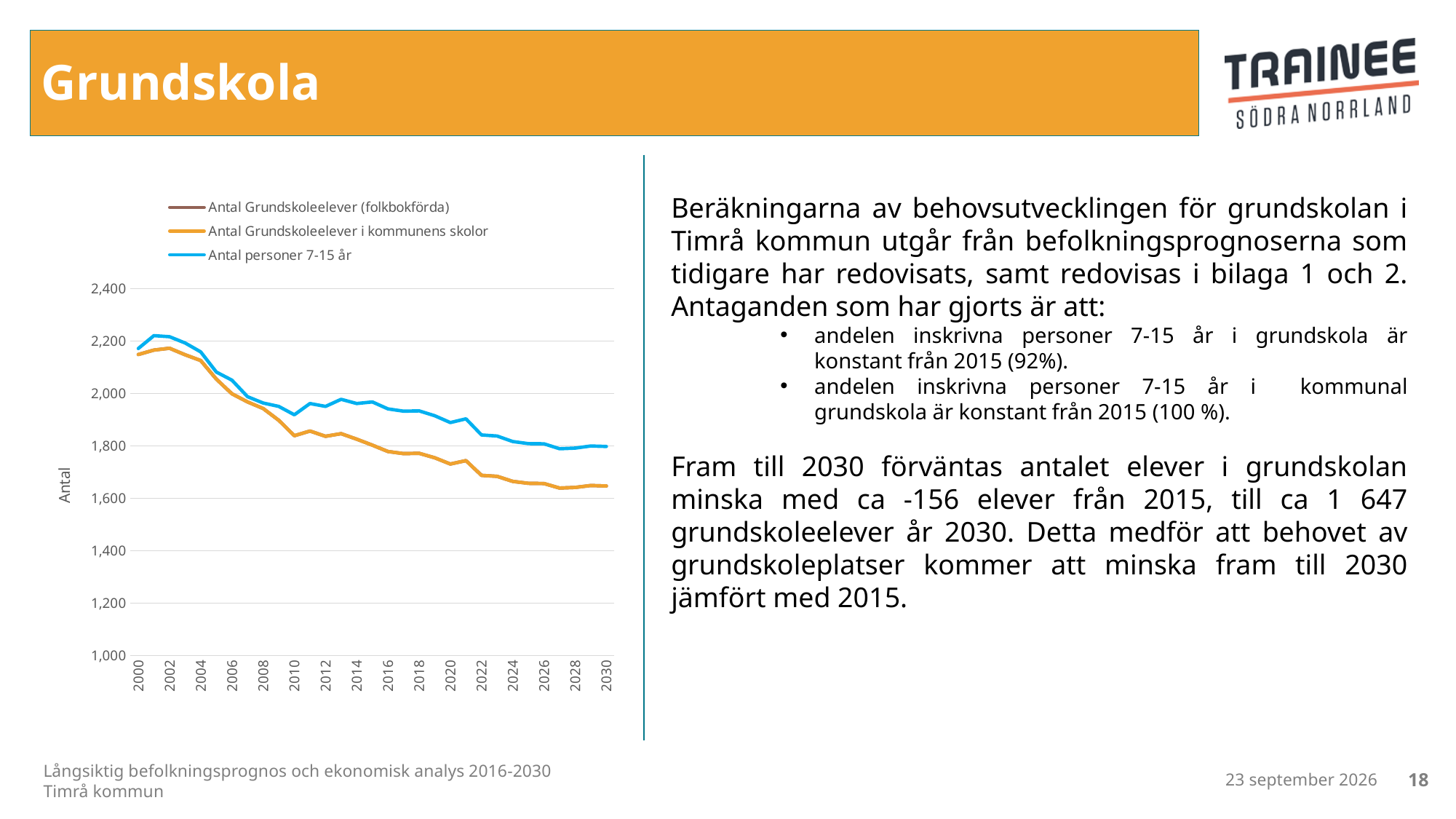
Is the value for 'Antal Grundskoleelever i kommunens skolor' in 2020 greater or less than 1,800? less Is the value for 'Antal personer 7-15 år' in 2020 greater or less than 1,800? greater How many series does the chart legend list? 3 What kind of chart is shown on the slide? Line chart Is the value for 'Antal Grundskoleelever i kommunens skolor' in 2030 greater or less than 1,800? less Do the values for 'Antal personer 7-15 år' rise or fall overall from 2000 to 2030? Fall Do the values for 'Antal Grundskoleelever i kommunens skolor' rise or fall overall from 2000 to 2030? Fall In 2030, which series has the higher value: 'Antal personer 7-15 år' or 'Antal Grundskoleelever i kommunens skolor'? Antal personer 7-15 år What is the last year shown on the horizontal axis of the chart? 2030 What is the label on the vertical axis of the chart? Antal